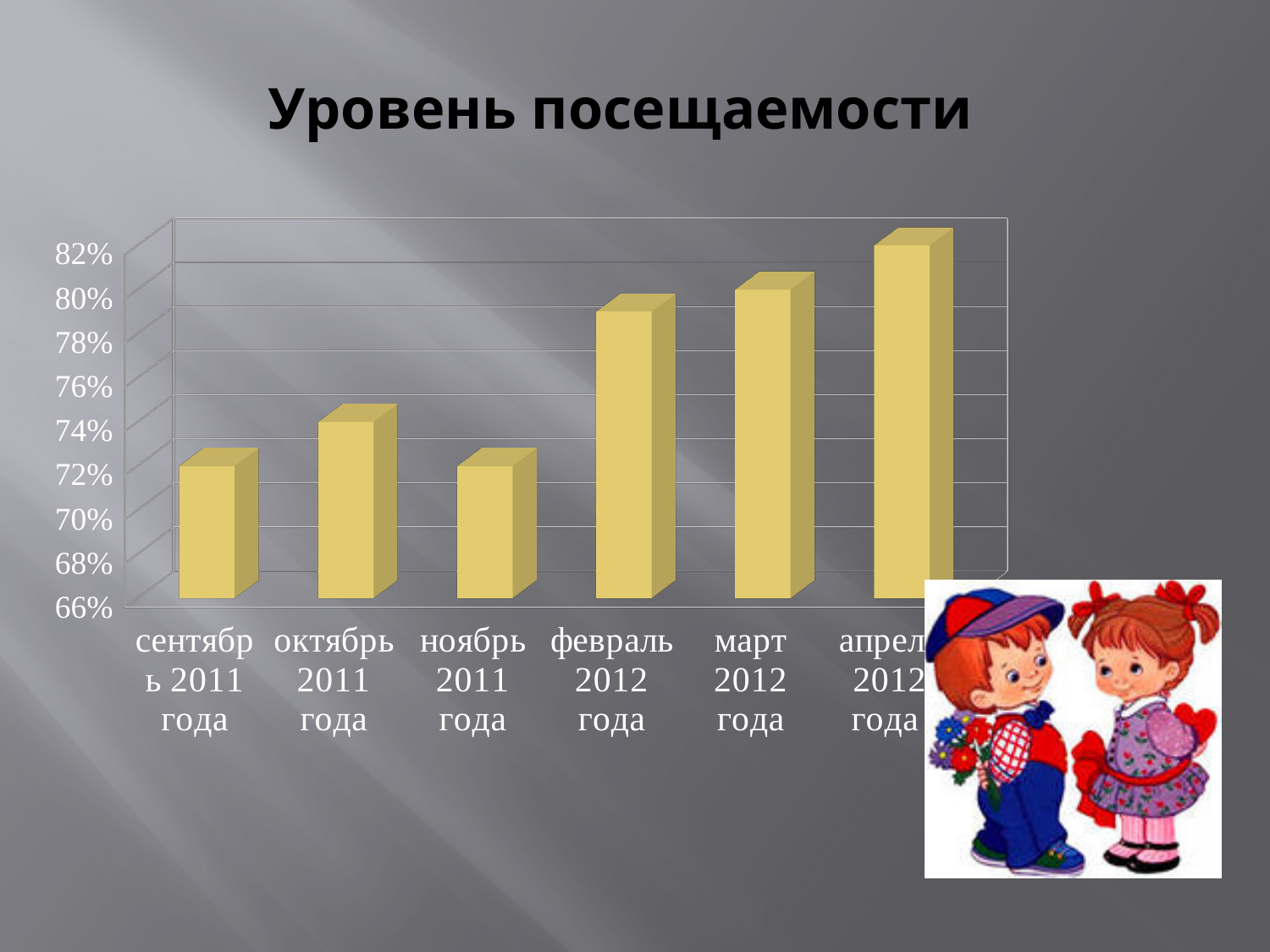
Is the value for февраль 2012 года greater or less than 78%? greater What is the title of the chart? Уровень посещаемости Is the value for сентябрь 2011 года greater or less than 74%? less How many categories (months) are shown on the x axis? 6 Which is larger, the value for февраль 2012 года or октябрь 2011 года? февраль 2012 года Is the value for март 2012 года greater or less than 78%? greater What kind of chart is shown on the slide? bar chart Which is larger, the value for март 2012 года or сентябрь 2011 года? март 2012 года Which month has the highest attendance level? апрель 2012 года Overall, do the values rise or fall from сентябрь 2011 to апрель 2012? rise